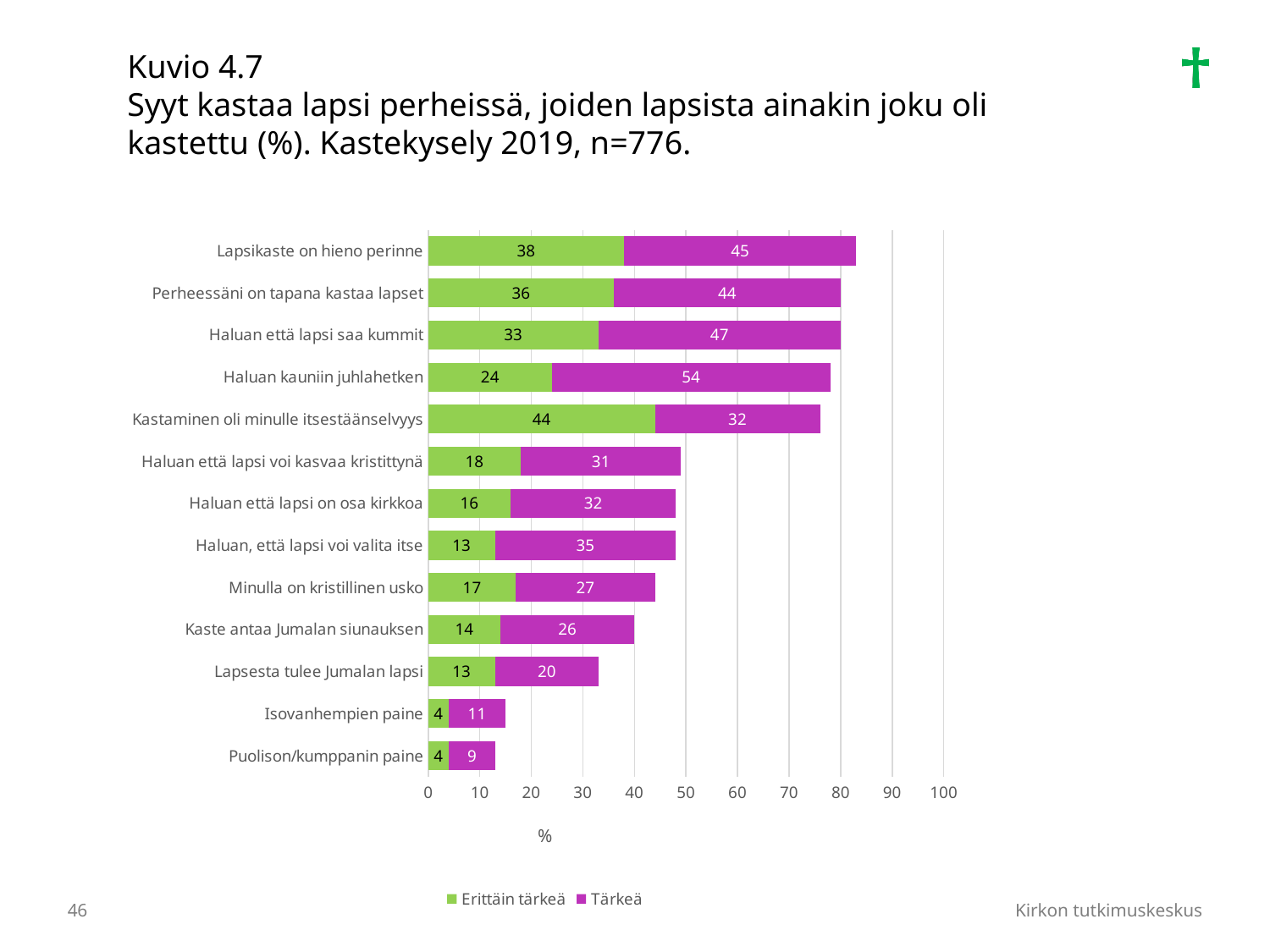
What is the difference between the 'Tärkeä' values for 'Haluan että lapsi saa kummit' and 'Perheessäni on tapana kastaa lapset'? 3 What is the 'Tärkeä' value for 'Haluan kauniin juhlahetken'? 54 Which is larger: the 'Erittäin tärkeä' value for 'Minulla on kristillinen usko' or for 'Kaste antaa Jumalan siunauksen'? Minulla on kristillinen usko Which colour represents the 'Tärkeä' series? Magenta (purple) Which category has the highest 'Erittäin tärkeä' value? Kastaminen oli minulle itsestäänselvyys What kind of chart is shown on the slide? Stacked bar chart What is the 'Erittäin tärkeä' value for 'Lapsikaste on hieno perinne'? 38 Which category has the lowest 'Tärkeä' value? Puolison/kumppanin paine What is the total of the stacked bar for 'Lapsikaste on hieno perinne'? 83 How many categories are shown in the chart? 13 How many series does the legend list? 2 What is the total of the stacked bar for 'Isovanhempien paine'? 15